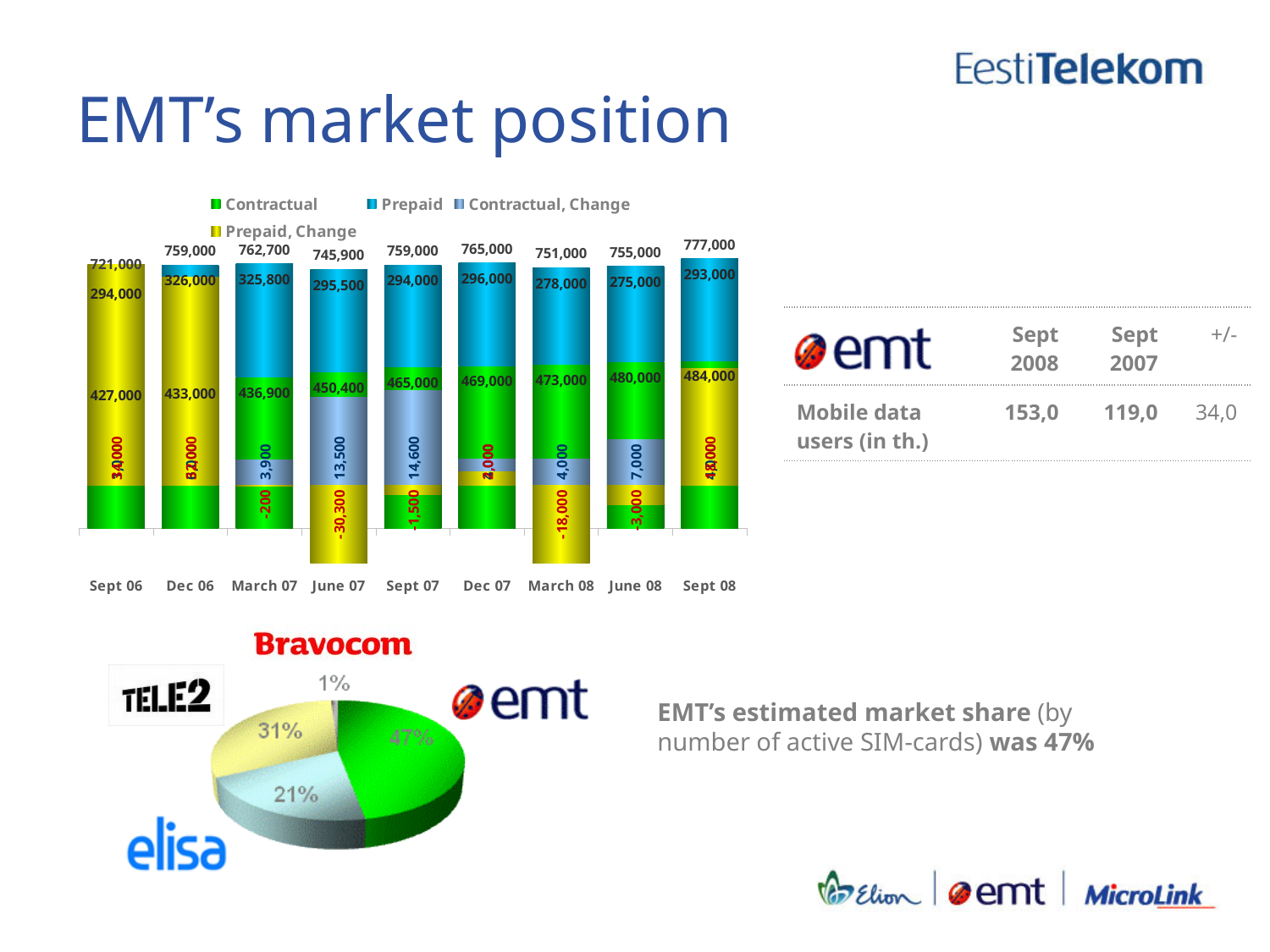
In the stacked bar chart, what is the Contractual value for June 07? 450,400 What kind of chart is shown at the bottom left of the slide? pie chart In the stacked bar chart, do the Contractual values rise or fall from Sept 06 to Sept 08? rise How many time periods are shown on the x axis of the stacked bar chart? 9 In the stacked bar chart, which period has the highest total? Sept 08 In the stacked bar chart, what is the difference between the Contractual values for Sept 08 and Sept 07? 19,000 In the stacked bar chart, what is the total number of customers shown for Sept 08? 777,000 How many series does the legend of the stacked bar chart list? 4 In the stacked bar chart, which period has the lowest total? Sept 06 In the stacked bar chart, what is the Prepaid value for Dec 06? 326,000 In the pie chart, what share of the market does Tele2 hold? 31% In the stacked bar chart, is the Prepaid value larger for March 07 or for March 08? March 07